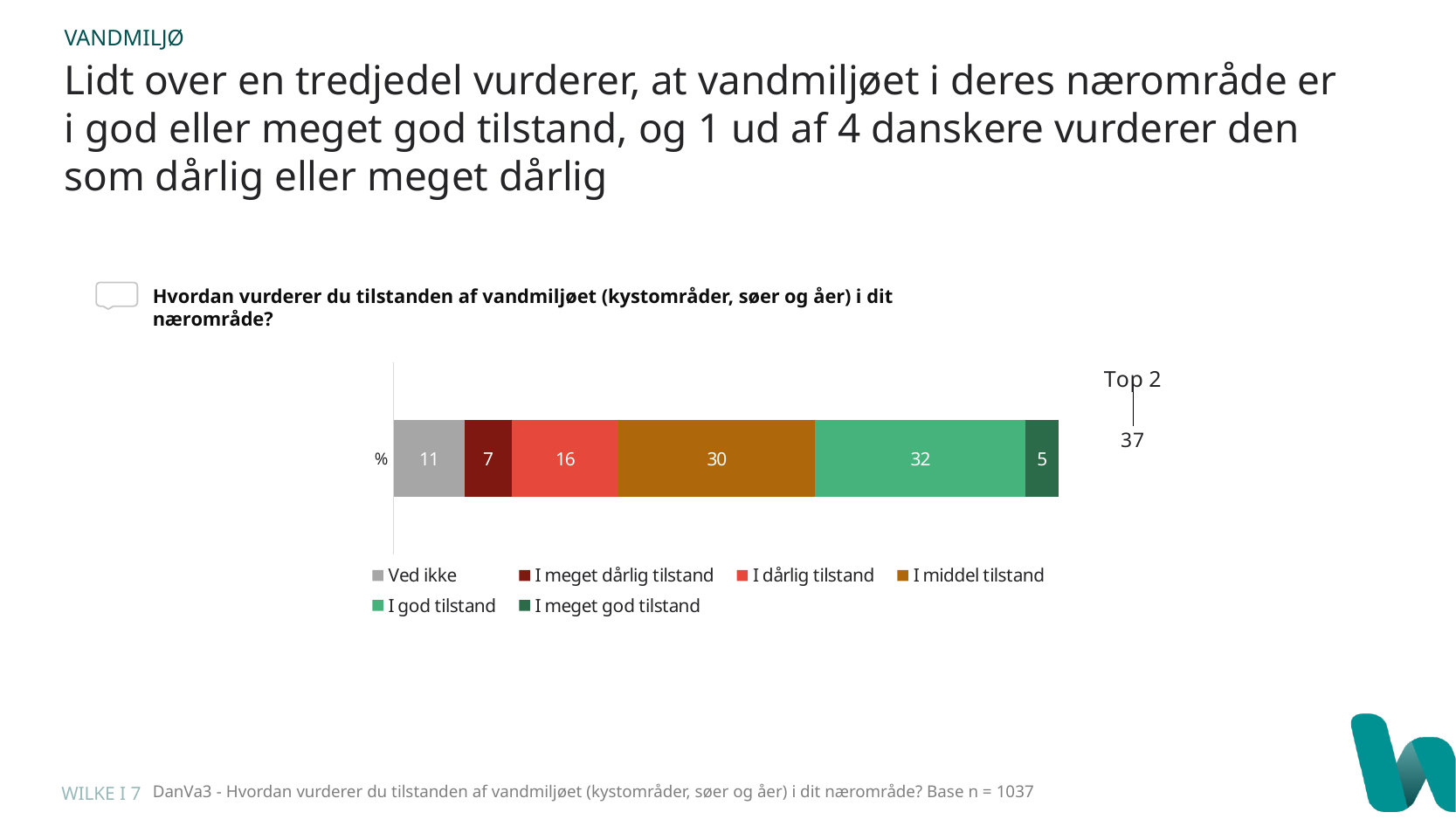
Which is larger, the value for "I dårlig tilstand" or the value for "Ved ikke"? I dårlig tilstand What kind of chart is shown on the slide? Stacked bar chart Which response category has the smallest segment in the bar? I meget god tilstand What is the value shown for "Ved ikke"? 11 What is the value shown for "I middel tilstand"? 30 How many series does the legend list? 6 Which response category has the largest segment in the bar? I god tilstand What is the "Top 2" value shown to the right of the bar? 37 What percentage of respondents answered "I god tilstand"? 32 What is the combined value of "I god tilstand" and "I meget god tilstand"? 37 What is the difference between the values for "I middel tilstand" and "I dårlig tilstand"? 14 What is the value shown for "I meget dårlig tilstand"? 7